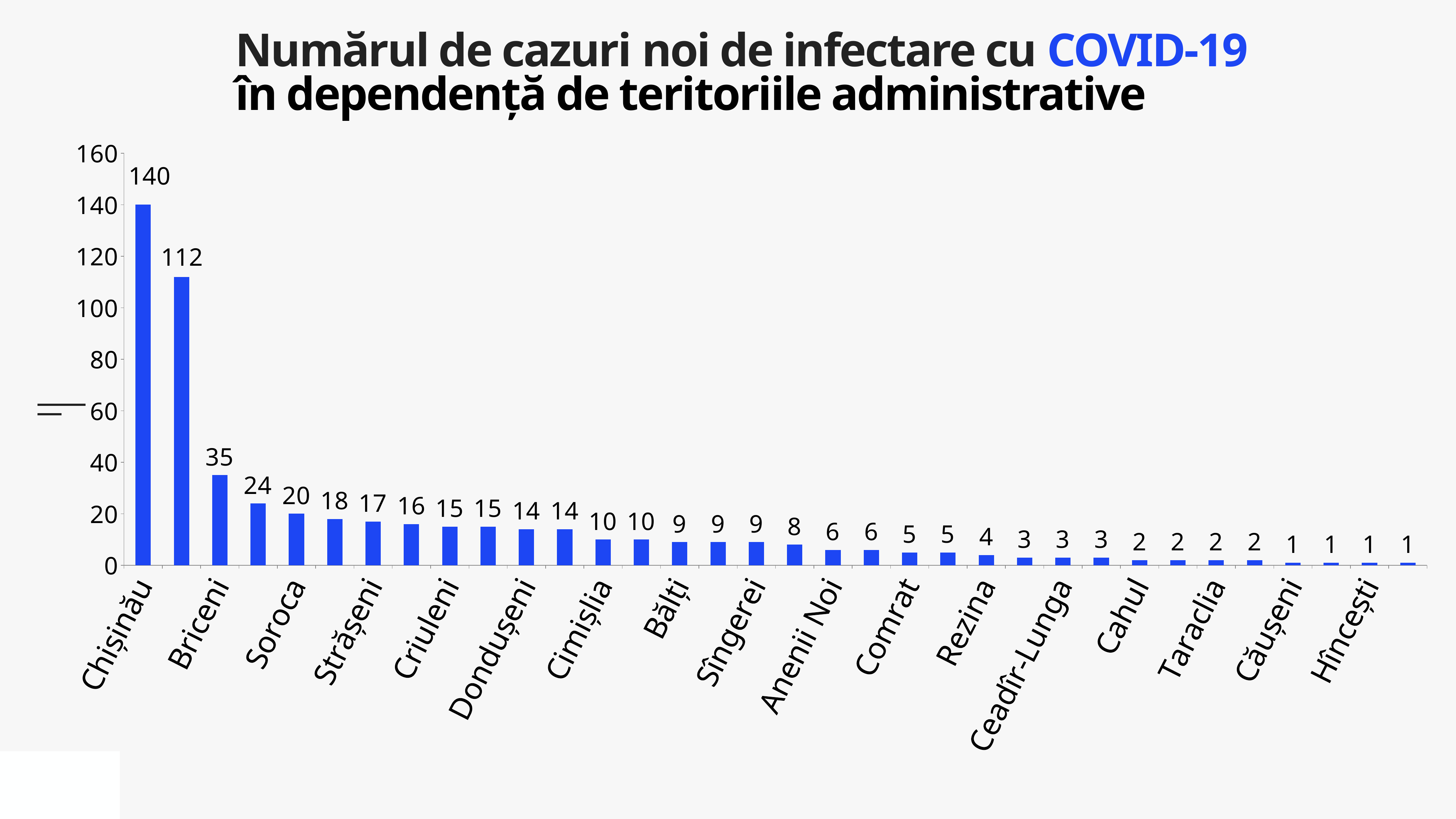
What is the difference between the two tallest bars on the chart? 28 What is the lowest value shown on the chart? 1 Is the value for Chișinău greater or less than 120? greater How many new cases are shown for Hîncești? 1 What kind of chart is shown on the slide? bar chart Which territory has the highest number of new COVID-19 cases? Chișinău How many new cases are shown for Criuleni? 15 How many new cases are shown for Bălți? 9 How many new cases are shown for Chișinău? 140 Do the values rise or fall from left to right along the x axis? fall What is the second highest value shown on the chart? 112 How many bars are plotted on the chart? 34